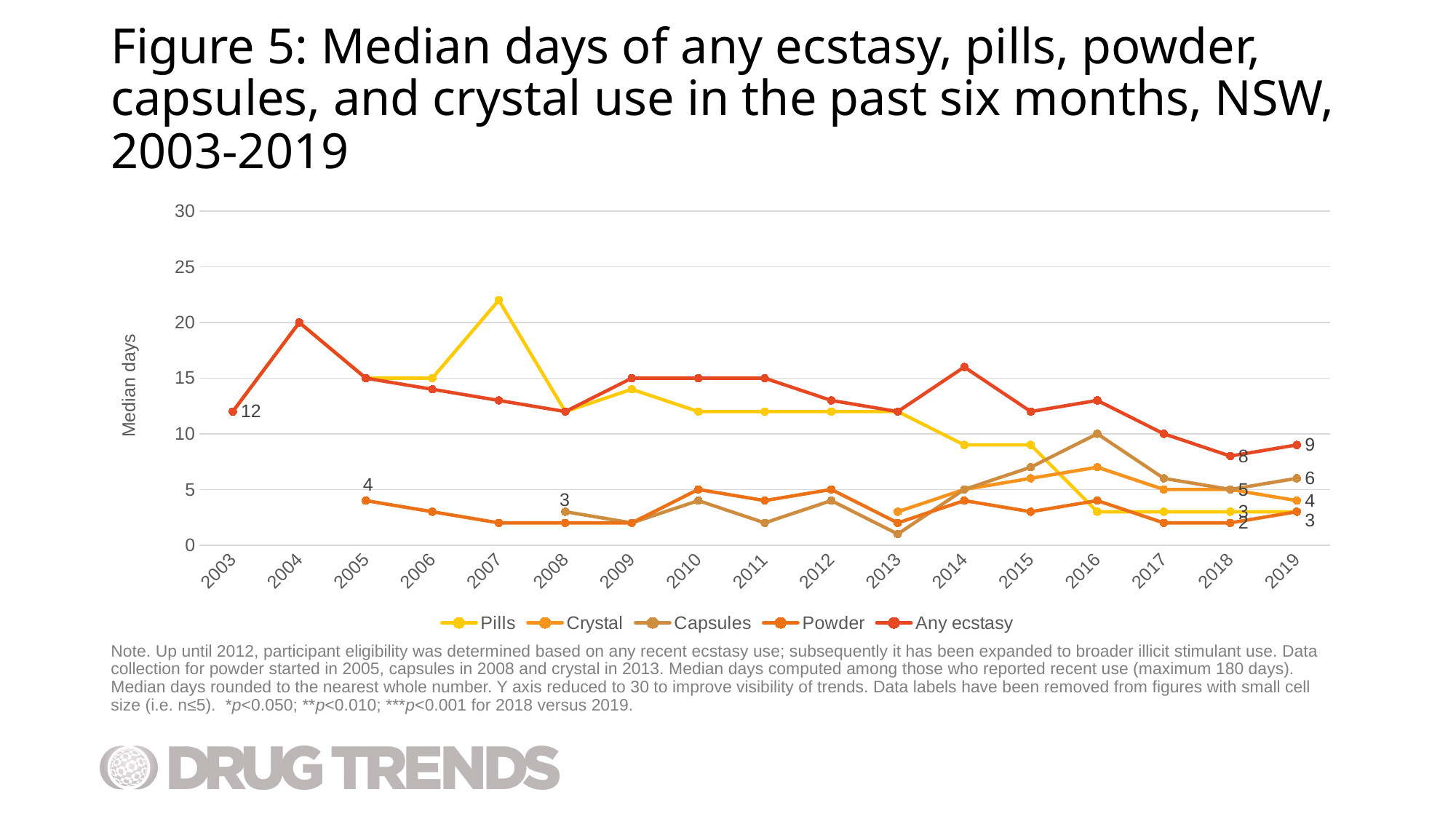
How many series does the legend list? 5 Is the value for Pills in 2007 greater or less than 20? greater What is the median days value for Any ecstasy in 2019? 9 By how many days did the Any ecstasy value change from 2018 to 2019? 1 How many years are plotted along the x axis? 17 What kind of chart is shown on the slide? line chart What is the median days value for Any ecstasy in 2003? 12 What is the label on the y axis? Median days What is the median days value for Any ecstasy in 2018? 8 Which series has the highest value in 2019? Any ecstasy What is the median days value for Capsules in 2019? 6 What is the median days value for Powder in 2005? 4